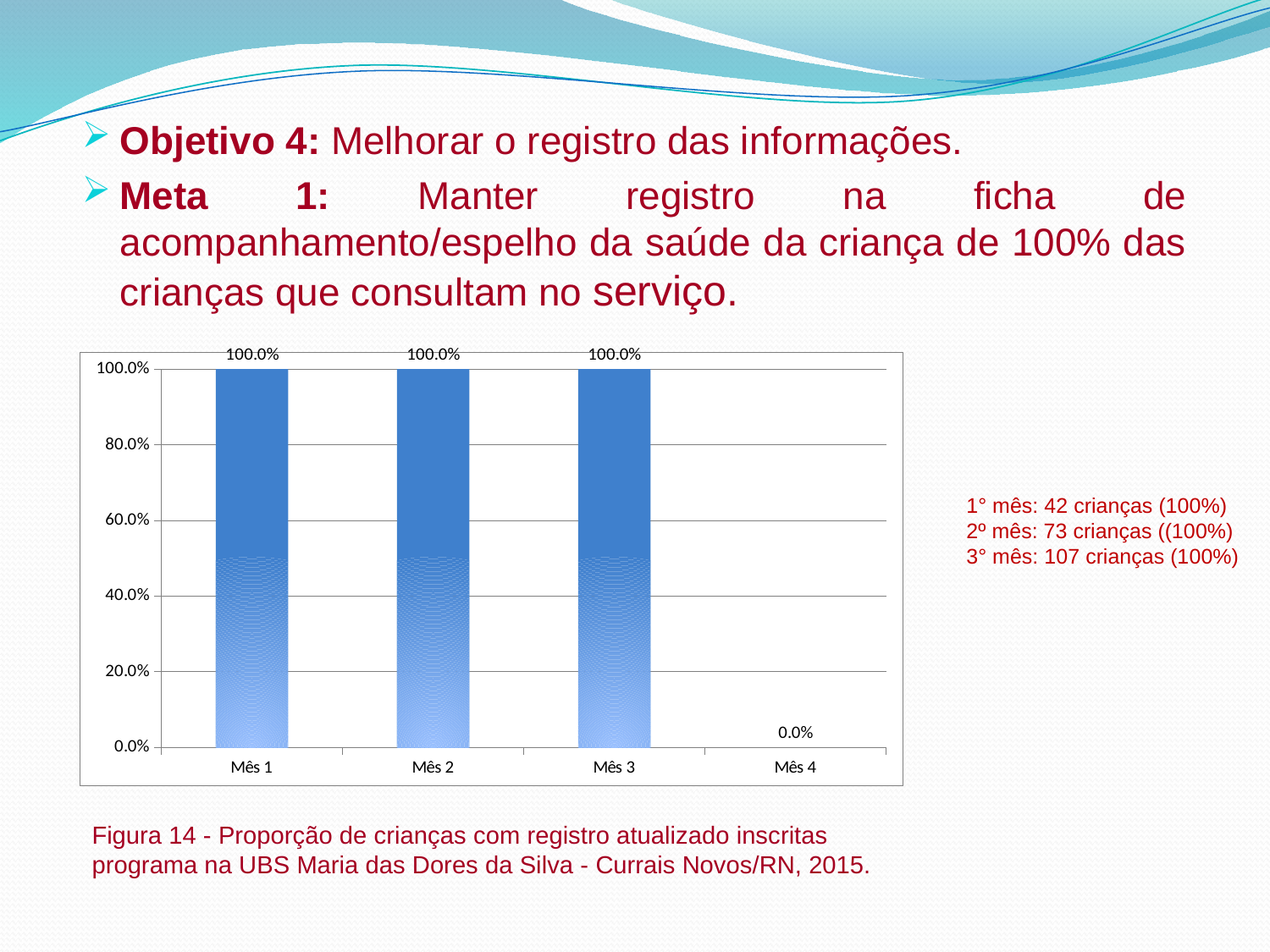
Do the values rise or fall from Mês 3 to Mês 4? fall What is the value for Mês 4? 0.0% How many categories have a value of 100.0%? 3 What is the figure number given in the caption below the chart? Figura 14 What kind of chart is shown on the slide? bar chart How many categories are shown on the x axis? 4 What is the value for Mês 1? 100.0% Which category has the lowest value? Mês 4 What is the difference between the values for Mês 2 and Mês 4? 100.0% Which is larger, the value for Mês 3 or the value for Mês 4? Mês 3 Is the value for Mês 2 greater or less than 80.0%? greater What is the value for Mês 3? 100.0%